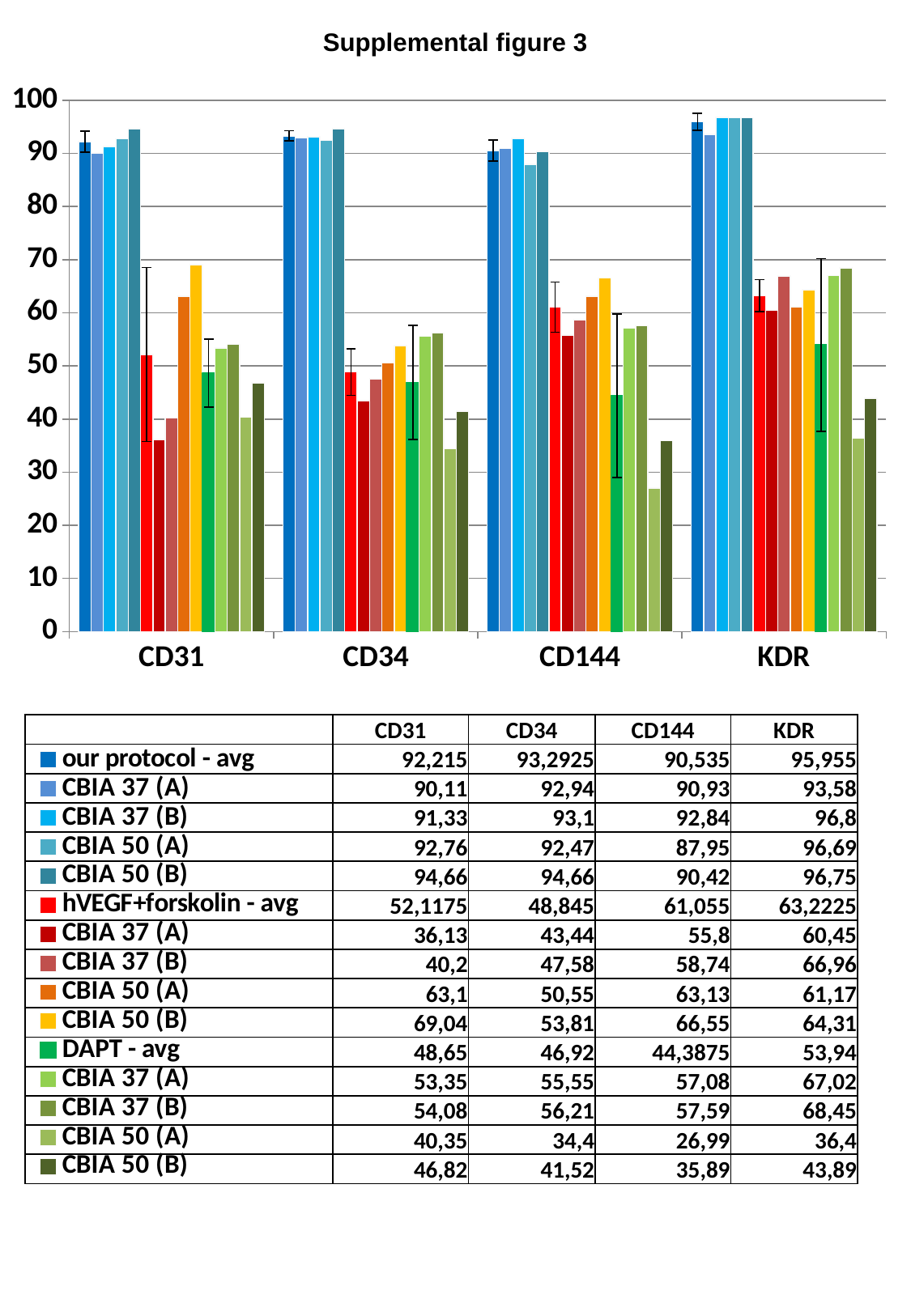
Is the 'our protocol - avg' value for CD34 greater or less than 90? greater What is the value of the 'hVEGF+forskolin - avg' series for CD144? 61,055 What is the value of the 'DAPT - avg' series for CD34? 46,92 What is the value of the 'our protocol - avg' series for KDR? 95,955 How many categories are shown on the x axis of the chart? 4 For the 'our protocol - avg' series, which category has the highest value? KDR For CD31, which is larger: the 'hVEGF+forskolin - avg' value or the 'DAPT - avg' value? hVEGF+forskolin - avg How many series are listed in the table below the chart? 15 What type of chart is shown on the slide? bar chart For the 'DAPT - avg' series, which category has the lowest value? CD144 What is the difference between the 'our protocol - avg' value and the 'hVEGF+forskolin - avg' value for CD31? 40,0975 For the 'hVEGF+forskolin - avg' series, which category has the lowest value? CD34